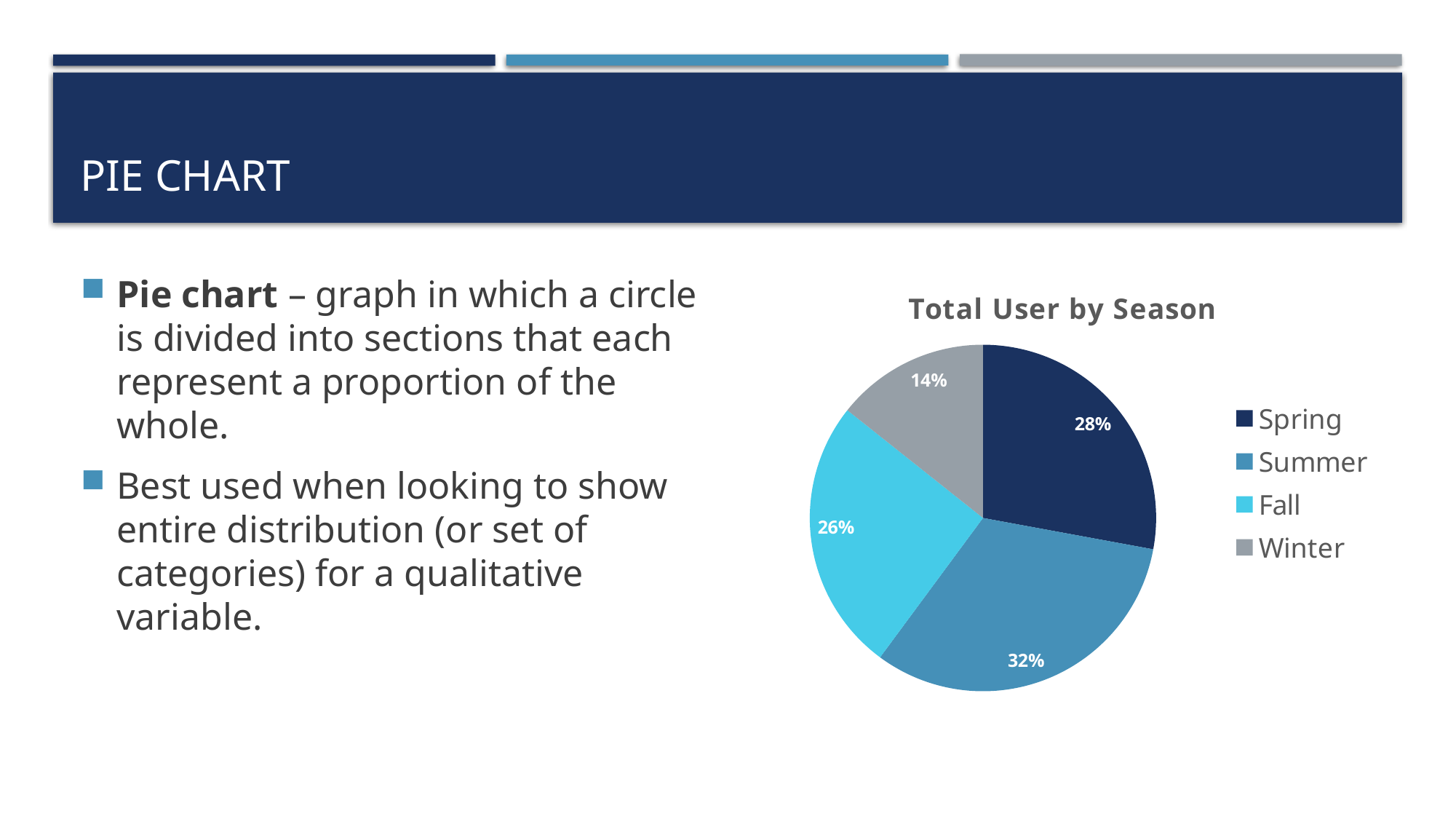
Which legend entry is shown in grey? Winter What kind of chart is shown on the slide? pie chart What share of the pie does Spring have? 28% Which season has the largest slice of the pie? Summer What is the title of the pie chart? Total User by Season Which season has the smallest slice of the pie? Winter What share of the pie does Winter have? 14% Which is larger, the Spring share or the Fall share? Spring How many categories does the pie chart show? 4 What share of the pie does Summer have? 32% What is the difference between the Summer and Winter shares? 18%